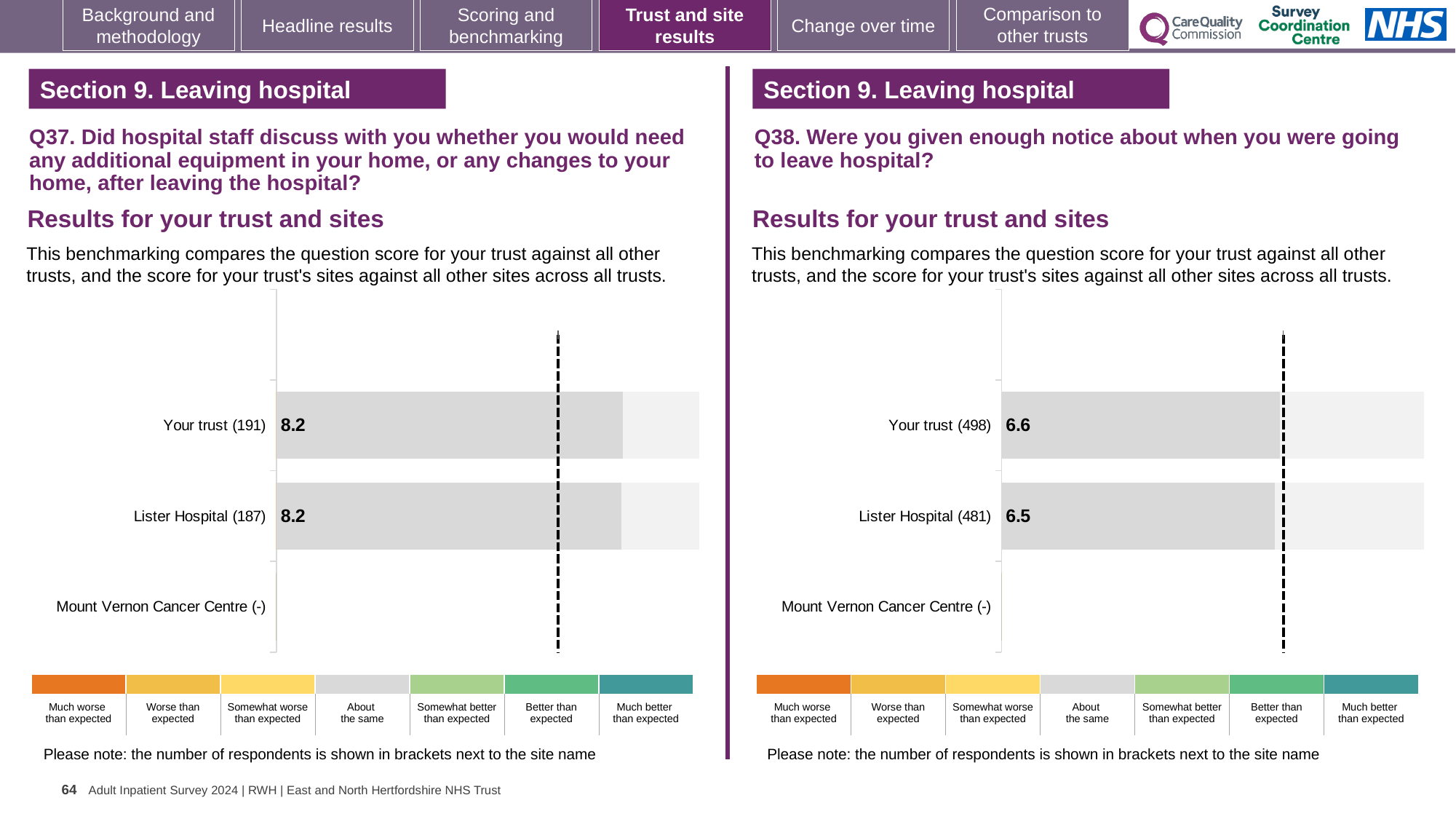
On the Q37 chart (left), what is the score for Lister Hospital? 8.2 What kind of chart is the Q38 chart (right)? Bar chart How many categories are listed on the Q37 chart (left)? 3 On the Q38 chart (right), what is the difference between the scores for Your trust and Lister Hospital? 0.1 On the Q37 chart (left), what is the difference between the scores for Your trust and Lister Hospital? 0 On the Q38 chart (right), what is the score for Your trust? 6.6 On the Q38 chart (right), how many respondents are shown in brackets for Lister Hospital? 481 On the Q38 chart (right), which has the higher score, Your trust or Lister Hospital? Your trust On the Q38 chart (right), what is the score for Lister Hospital? 6.5 On the Q37 chart (left), what is the score for Your trust? 8.2 How many categories are listed on the Q38 chart (right)? 3 On the Q37 chart (left), how many respondents are shown in brackets for Your trust? 191